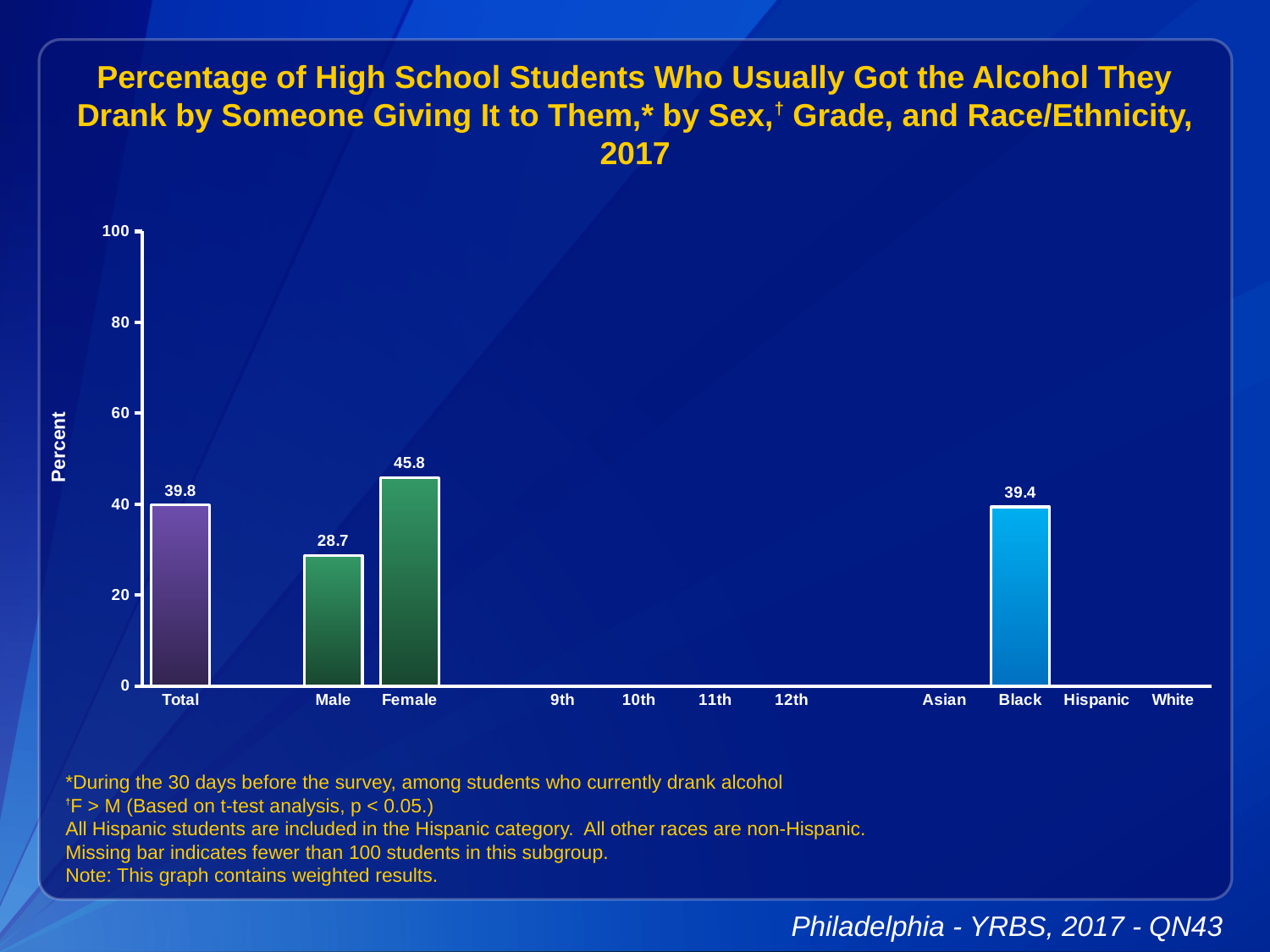
Which category has the highest value? Female What is the value for Black? 39.4 What is the label of the y axis? Percent What is the difference between the Female and Male values? 17.1 What is the value for Total? 39.8 What is the value for Female? 45.8 How many bars are plotted on the chart? 4 Is the value for Male greater or less than 40? less What is the value for Male? 28.7 Which is larger, the value for Total or the value for Black? Total What kind of chart is shown? bar chart Which category has the lowest value among the plotted bars? Male